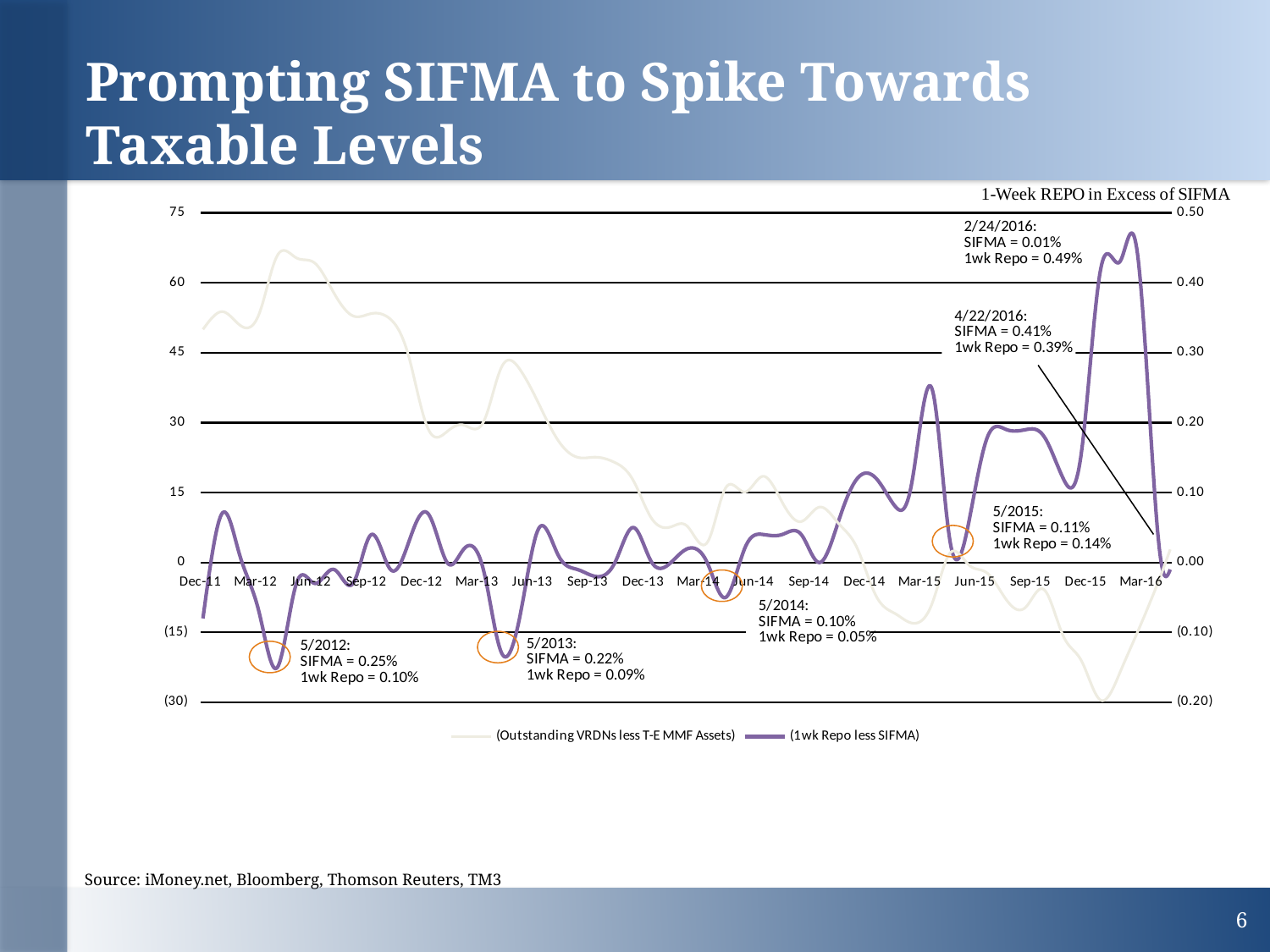
Among the annotated dates, which one shows the highest 1wk Repo value? 2/24/2016 How many series does the chart legend list? 2 What are the two series named in the chart legend? (Outstanding VRDNs less T-E MMF Assets) and (1wk Repo less SIFMA) According to the annotation, what was SIFMA on 2/24/2016? 0.01% On 4/22/2016, which was larger according to the annotation: SIFMA or the 1wk Repo? SIFMA According to the annotation, what was SIFMA in 5/2012? 0.25% According to the annotation, what was SIFMA on 4/22/2016? 0.41% By how much did the 1wk Repo exceed SIFMA on 2/24/2016, based on the annotated values? 0.48% According to the annotation, what was the 1wk Repo in 5/2014? 0.05% What kind of chart is shown on the slide? line chart According to the annotation, what was the 1wk Repo on 2/24/2016? 0.49% What is the title of the chart? 1-Week REPO in Excess of SIFMA